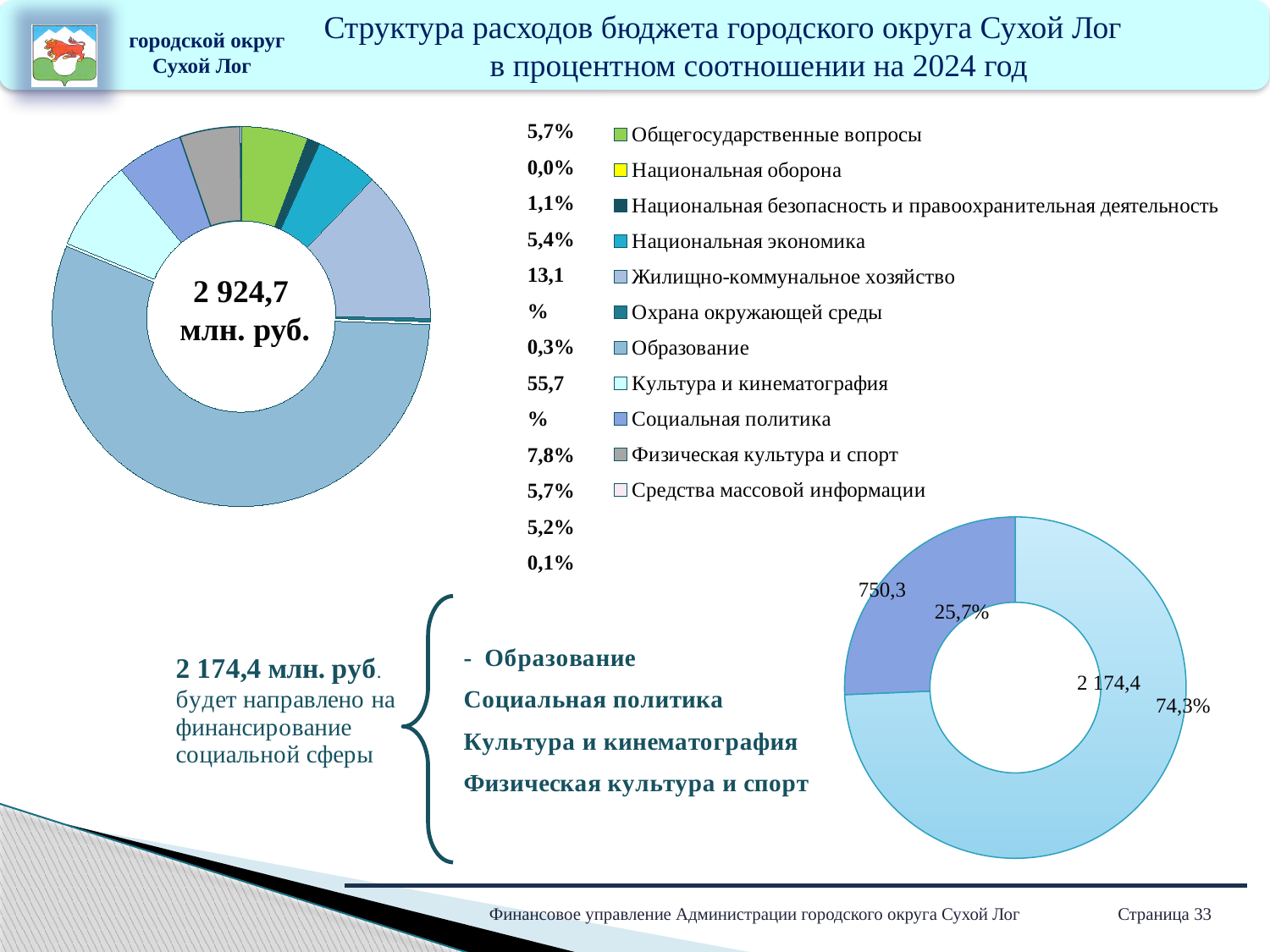
In the chart at the bottom right, how many slices does the donut have? 2 In the chart at the bottom right, what is the difference between the two slice values, 2 174,4 and 750,3? 1 424,1 In the left chart, what is the share of Жилищно-коммунальное хозяйство? 13,1% In the left chart, which is larger: the share of Образование or the share of Жилищно-коммунальное хозяйство? Образование In the left chart, which category has the largest share? Образование What kind of chart is the chart on the left of the slide? pie chart (donut) In the left chart, what is the share of Национальная оборона? 0,0% In the left chart, what total value is shown in the centre of the donut? 2 924,7 млн. руб. In the chart at the bottom right, what value is labelled on the larger slice? 2 174,4 How many categories does the legend of the left chart list? 11 In the left chart, what is the share of Образование? 55,7% In the chart at the bottom right, what percentage is shown for the smaller slice? 25,7%